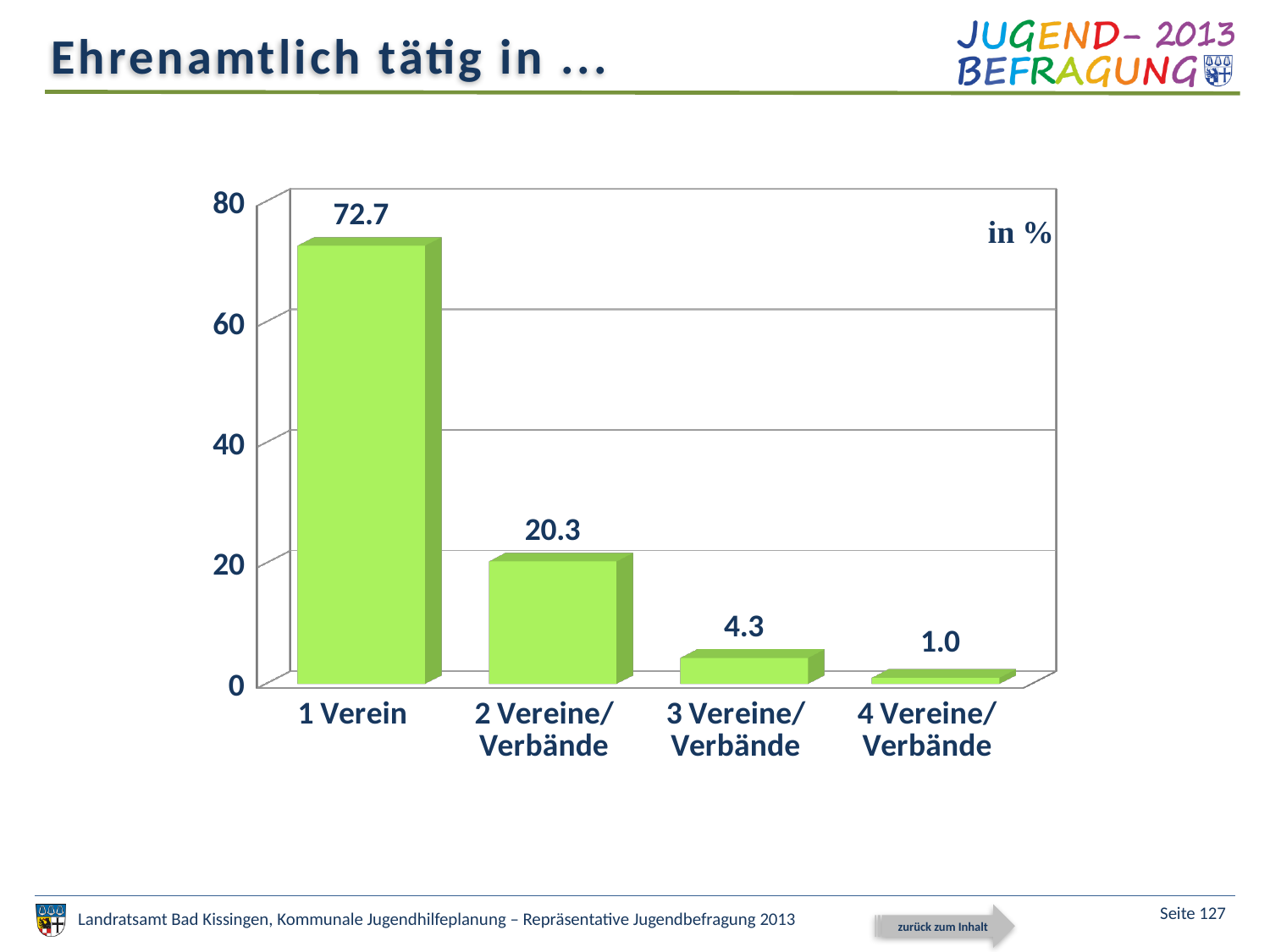
Which category has the highest value? 1 Verein What is the value for "3 Vereine/Verbände"? 4.3 Do the values rise or fall from left to right along the x axis? fall Which is larger, the value for "3 Vereine/Verbände" or "4 Vereine/Verbände"? 3 Vereine/Verbände What is the value for "4 Vereine/Verbände"? 1.0 Which category has the lowest value? 4 Vereine/Verbände What is the difference between the values for "1 Verein" and "2 Vereine/Verbände"? 52.4 Is the value for "2 Vereine/Verbände" greater or less than 40? less How many categories are shown on the x axis? 4 What is the value for "2 Vereine/Verbände"? 20.3 What kind of chart is shown on the slide? bar chart What is the value for "1 Verein"? 72.7